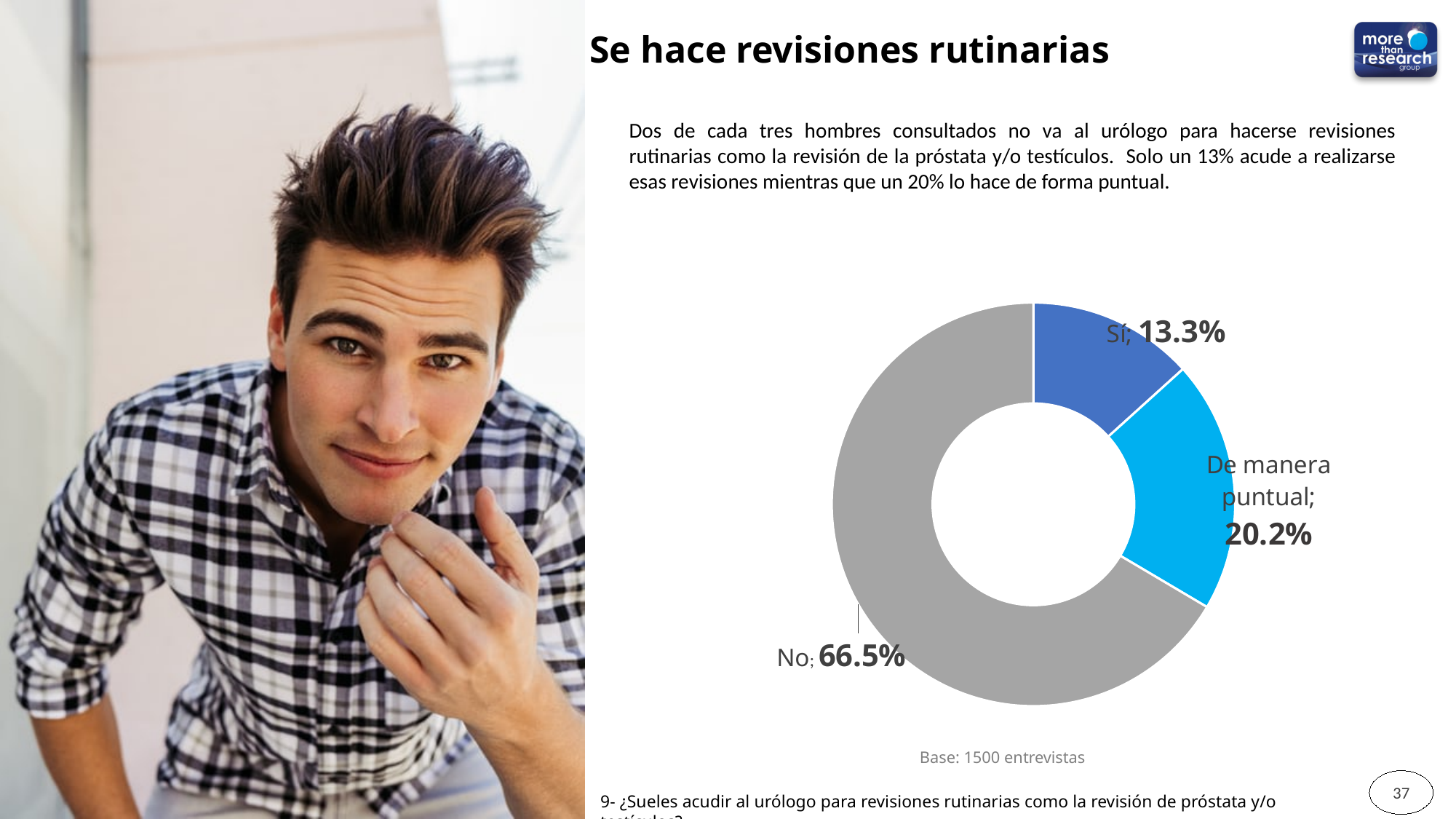
What percentage of respondents answered "De manera puntual"? 20.2% Which is larger, the share for "De manera puntual" or the share for "Sí"? De manera puntual What percentage of respondents answered "Sí"? 13.3% Which category has the smallest share of the chart? Sí What is the base (number of interviews) stated below the chart? 1500 entrevistas What colour is the "No" segment of the chart? Grey What kind of chart is shown on the slide? Doughnut chart What is the difference in percentage points between "De manera puntual" and "Sí"? 6.9 Which category has the largest share of the chart? No How many categories are shown in the chart? 3 What is the difference in percentage points between "No" and "Sí"? 53.2 What percentage of respondents answered "No"? 66.5%